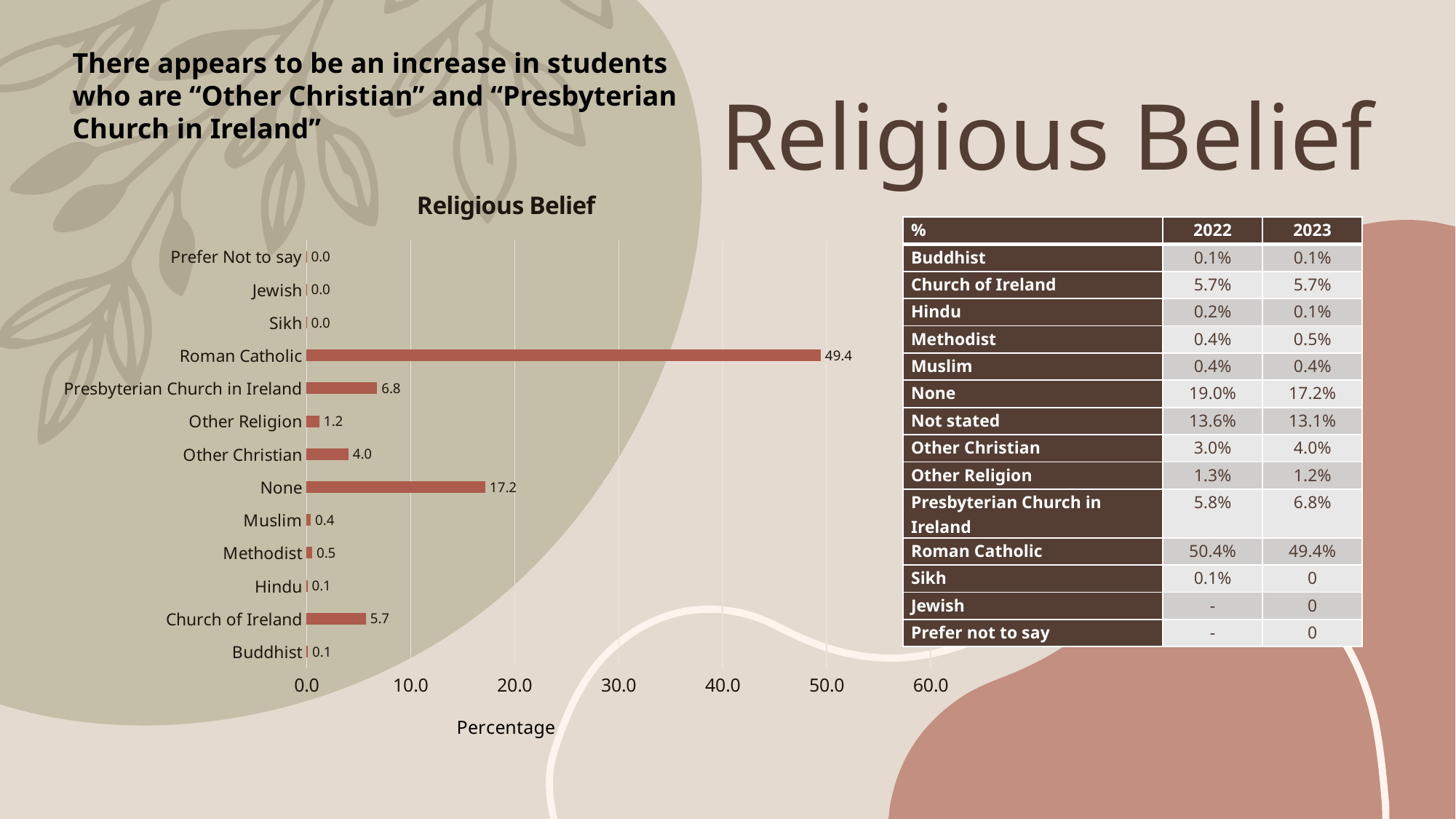
What is the difference between the values for Presbyterian Church in Ireland and Church of Ireland in the Religious Belief chart? 1.1 What is the difference between the values for Roman Catholic and None in the Religious Belief chart? 32.2 What is the value for Presbyterian Church in Ireland in the Religious Belief chart? 6.8 What kind of chart is the Religious Belief chart? bar chart Which is larger in the Religious Belief chart, Other Christian or Other Religion? Other Christian What is the value for Roman Catholic in the Religious Belief chart? 49.4 Is the value for Roman Catholic in the Religious Belief chart greater or less than 40.0? greater Which category has the highest value in the Religious Belief chart? Roman Catholic What is the label of the horizontal axis in the Religious Belief chart? Percentage What is the value for None in the Religious Belief chart? 17.2 What is the value for Church of Ireland in the Religious Belief chart? 5.7 How many categories are shown in the Religious Belief chart? 13